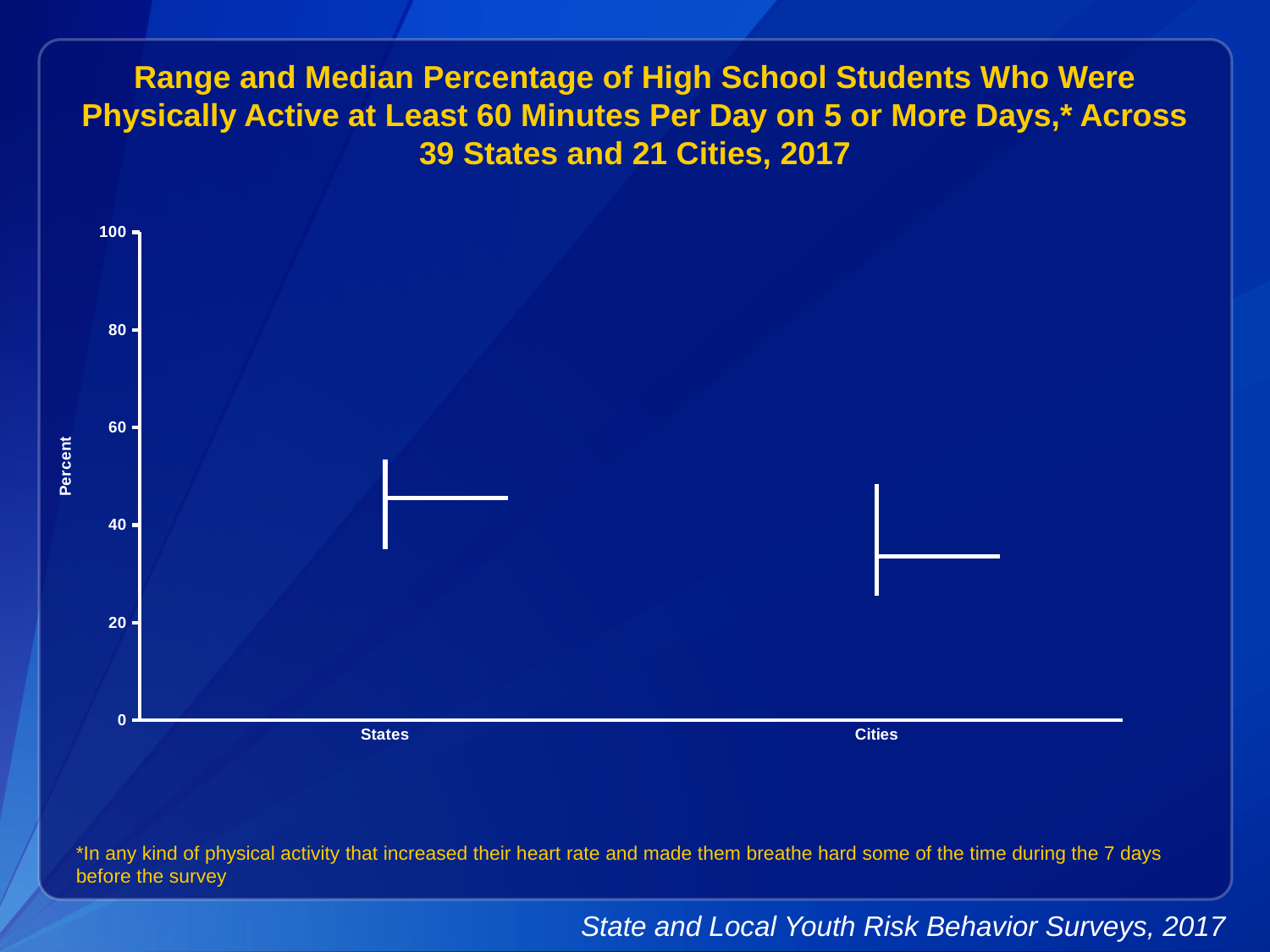
Which category has the higher median percentage, States or Cities? States How many categories are shown on the x axis of the chart? 2 Is the median value for States greater or less than 60? less Is the median value for Cities greater or less than 40? less Is the top of the range for States greater or less than 60? less Which category has the lower median percentage? Cities What is the highest value shown on the y axis? 100 What is the label on the y axis of the chart? Percent What are the two categories shown on the x axis? States and Cities